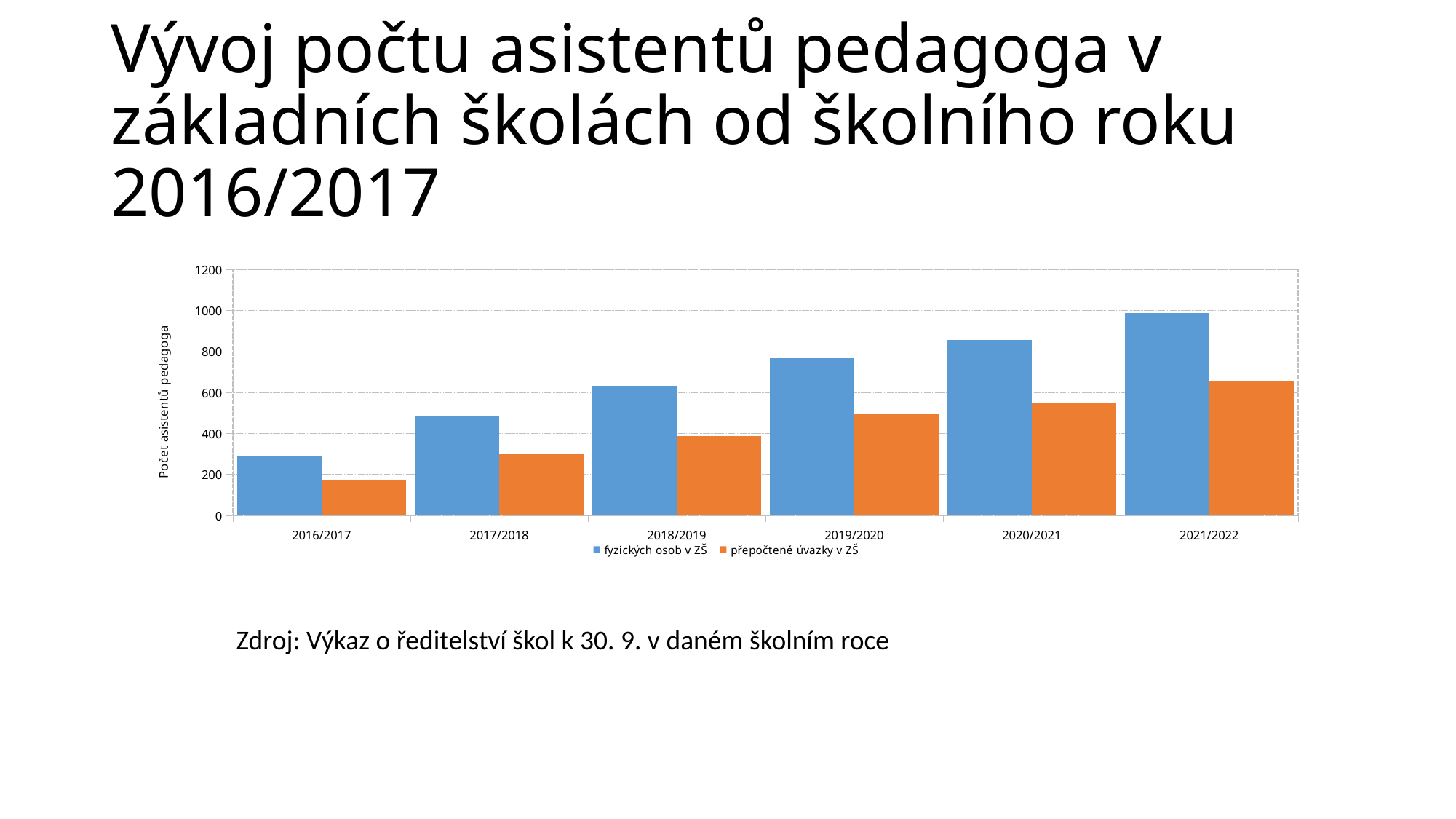
What kind of chart is shown on the slide? bar chart What is the label of the vertical axis? Počet asistentů pedagoga Is the value for přepočtené úvazky v ZŠ in 2016/2017 greater or less than 200? less How many series does the legend list? 2 Is the value for fyzických osob v ZŠ in 2021/2022 greater or less than 800? greater Do the values for fyzických osob v ZŠ rise or fall from 2016/2017 to 2021/2022? rise Is the value for přepočtené úvazky v ZŠ in 2021/2022 greater or less than 600? greater Which school year has the highest value for fyzických osob v ZŠ? 2021/2022 Which school year has the lowest value for přepočtené úvazky v ZŠ? 2016/2017 In 2019/2020, which is larger: fyzických osob v ZŠ or přepočtené úvazky v ZŠ? fyzických osob v ZŠ How many school years are shown on the x axis? 6